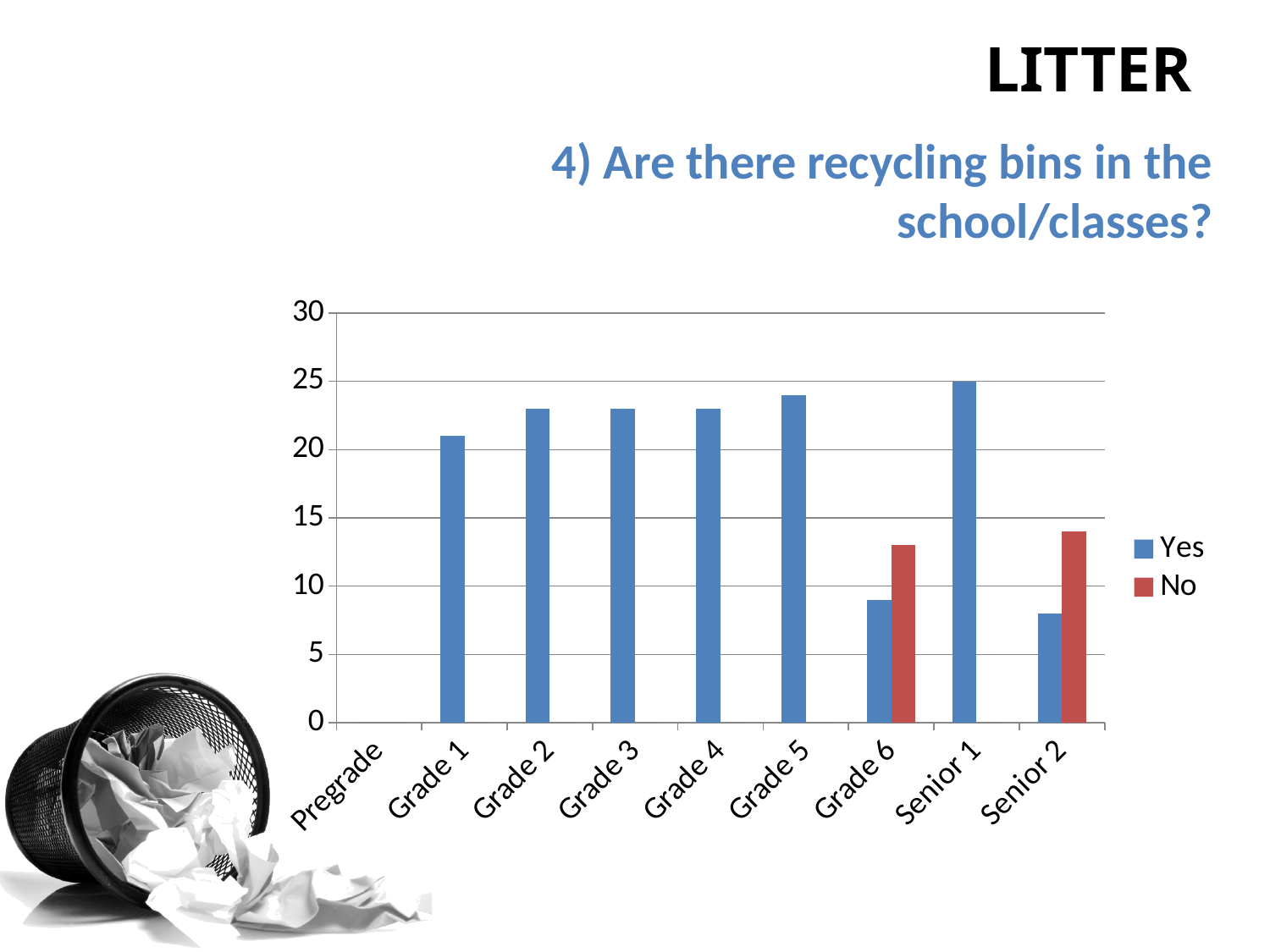
Which is larger, the Yes value for Grade 5 or the Yes value for Grade 1? Grade 5 For Senior 2, which is larger, the Yes value or the No value? No What colour represents the No series in the legend? red Is the No value for Grade 6 greater or less than 10? greater How many series does the legend list? 2 Which category has the highest Yes value? Senior 1 How many categories are shown on the x axis? 9 What kind of chart is shown on the slide? bar chart Is the Yes value for Grade 1 greater or less than 20? greater Is the No value for Senior 2 greater or less than 15? less What is the Yes value for Senior 1? 25